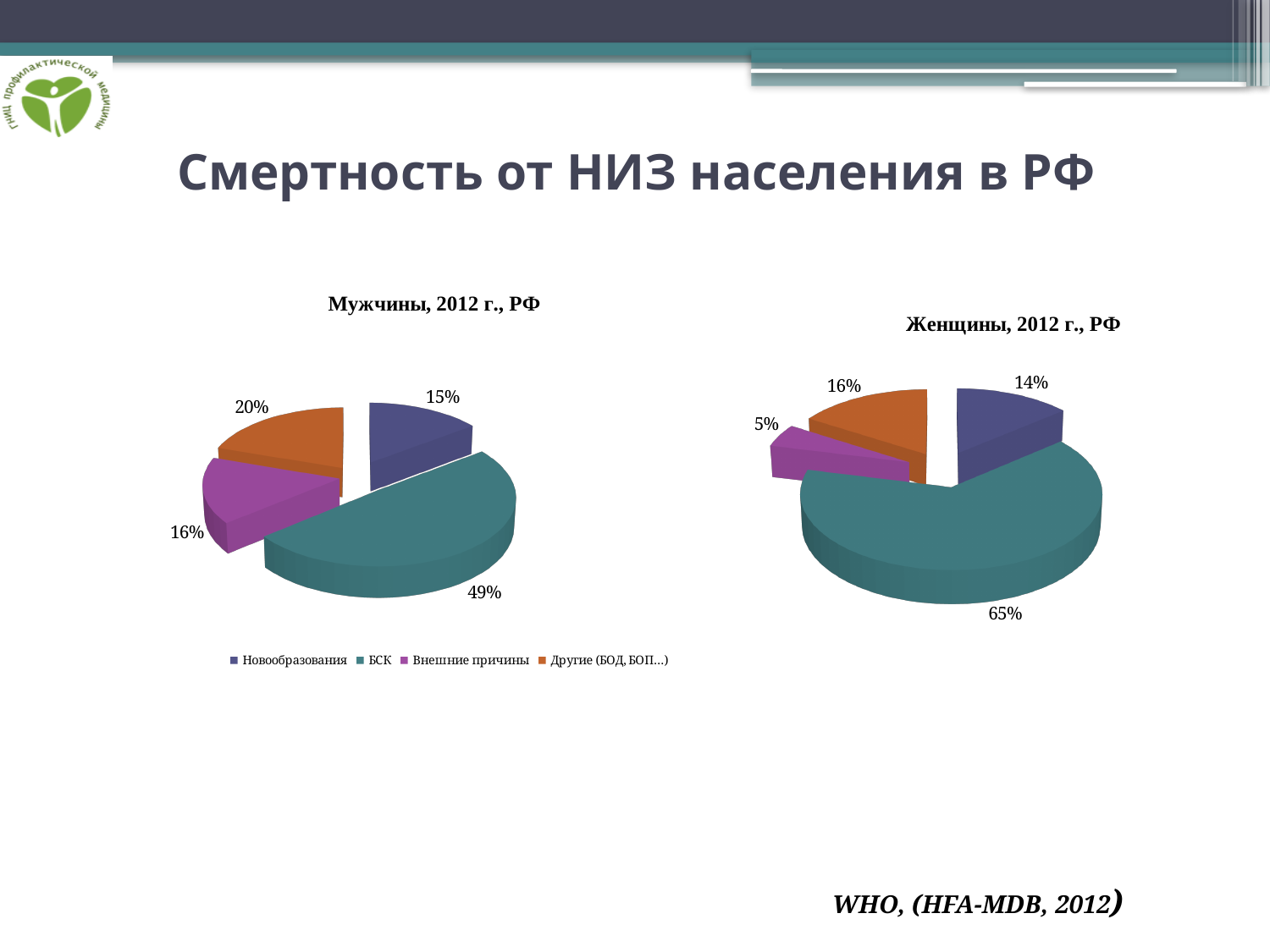
How many slices does the chart titled "Женщины, 2012 г., РФ" have? 4 In the chart titled "Мужчины, 2012 г., РФ", what is the value for Другие (БОД, БОП...)? 20% In the chart titled "Женщины, 2012 г., РФ", what share of the pie is БСК? 65% What is the difference between the БСК share in the "Женщины, 2012 г., РФ" chart and the БСК share in the "Мужчины, 2012 г., РФ" chart? 16% How many entries does the legend below the "Мужчины, 2012 г., РФ" chart list? 4 What type of chart is used for "Мужчины, 2012 г., РФ"? Pie chart In the chart titled "Женщины, 2012 г., РФ", what is the value for Внешние причины? 5% In the chart titled "Мужчины, 2012 г., РФ", what share of the pie is БСК? 49% In the chart titled "Мужчины, 2012 г., РФ", which category has the largest slice? БСК In the chart titled "Мужчины, 2012 г., РФ", which category has the smallest slice? Новообразования Which is larger: the Внешние причины share in the "Мужчины, 2012 г., РФ" chart or in the "Женщины, 2012 г., РФ" chart? Мужчины, 2012 г., РФ In the chart titled "Женщины, 2012 г., РФ", which category has the smallest slice? Внешние причины